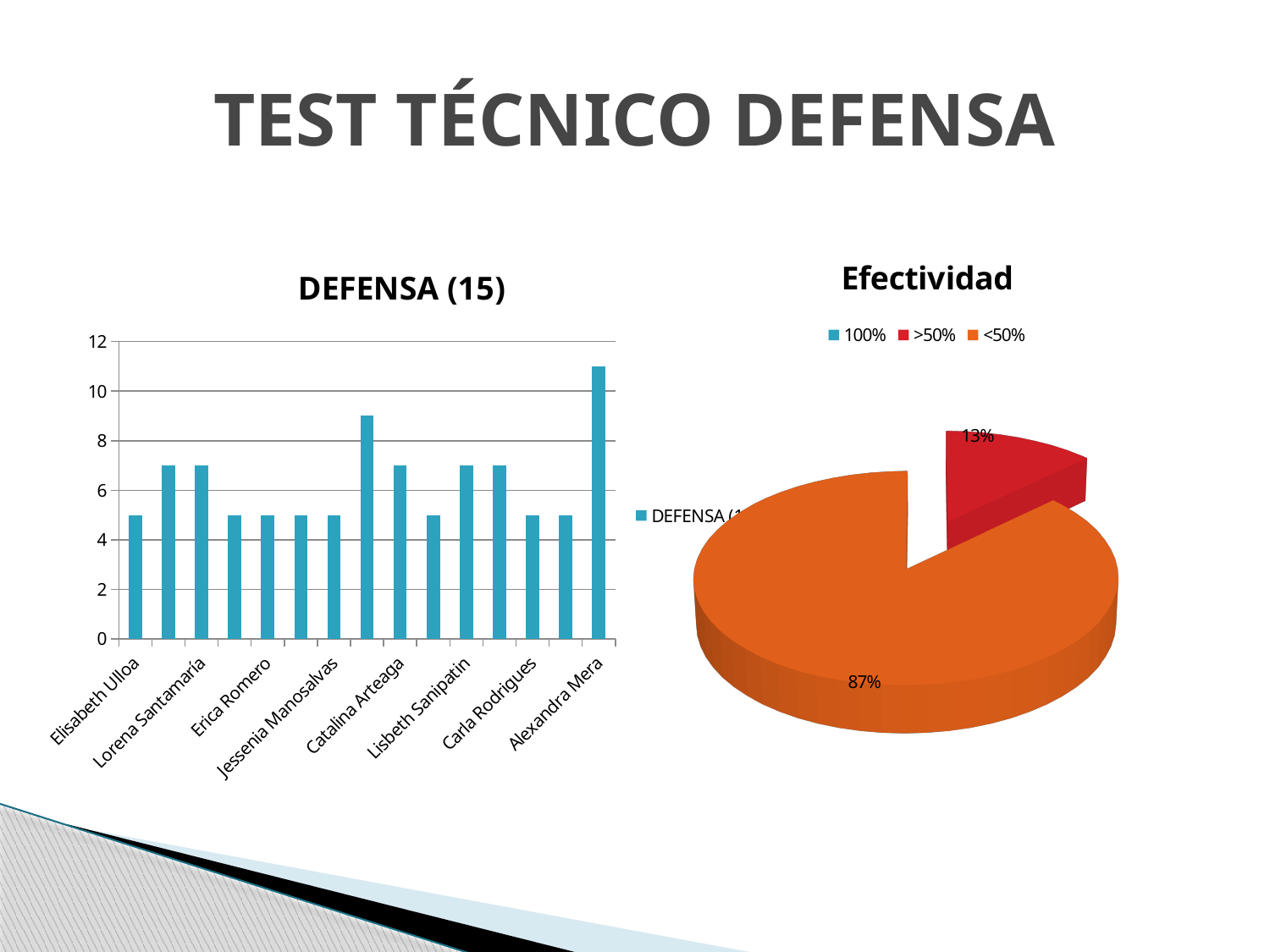
What kind of chart is the DEFENSA (15) chart on the left? bar chart In the DEFENSA (15) chart, which is larger, the value for Alexandra Mera or the value for Carla Rodrigues? Alexandra Mera In the DEFENSA (15) chart, is the value for Elisabeth Ulloa greater or less than 6? less In the DEFENSA (15) chart, how many bars are plotted? 15 In the DEFENSA (15) chart, is the value for Alexandra Mera greater or less than 10? greater What kind of chart is the Efectividad chart on the right? pie chart In the Efectividad pie chart, what share does the <50% slice have? 87% In the Efectividad pie chart, what share does the >50% slice have? 13% In the DEFENSA (15) chart, is the value for Lorena Santamaría greater or less than 6? greater In the DEFENSA (15) chart, which person has the highest value? Alexandra Mera In the Efectividad pie chart, which legend category has the largest slice? <50% How many entries does the legend of the Efectividad chart list? 3